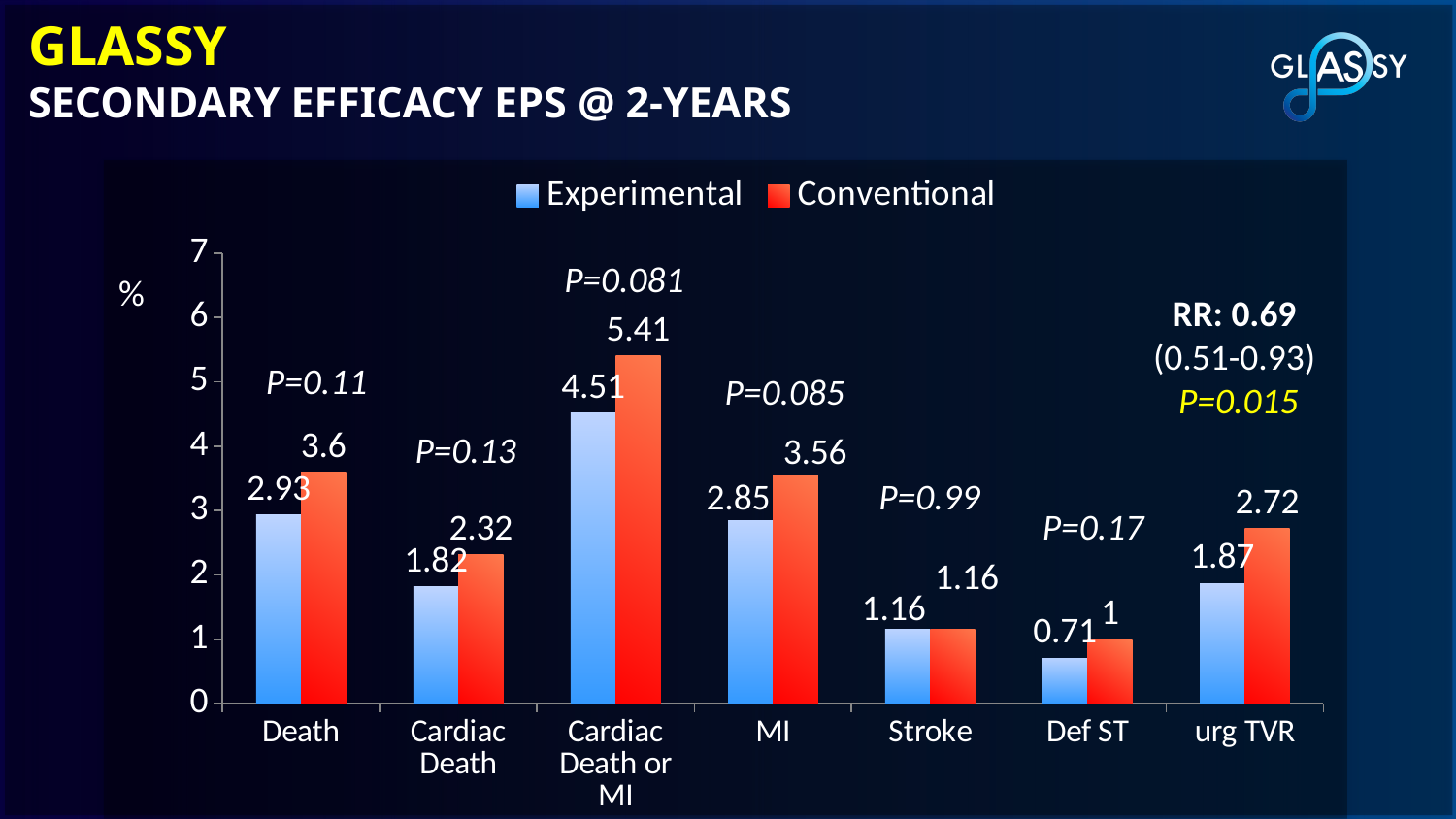
How many series does the legend list? 2 Which category has the lowest Experimental value? Def ST Which category has the highest Conventional value? Cardiac Death or MI What is the RR value shown on the chart? 0.69 What is the Conventional value for urg TVR? 2.72 What P value is shown above the Stroke bars? P=0.99 How many categories are shown on the x axis? 7 Which is larger for Cardiac Death: the Experimental or the Conventional value? Conventional What is the difference between the Conventional and Experimental values for MI? 0.71 What kind of chart is shown? Bar chart What is the Experimental value for Death? 2.93 What is the Conventional value for Cardiac Death or MI? 5.41